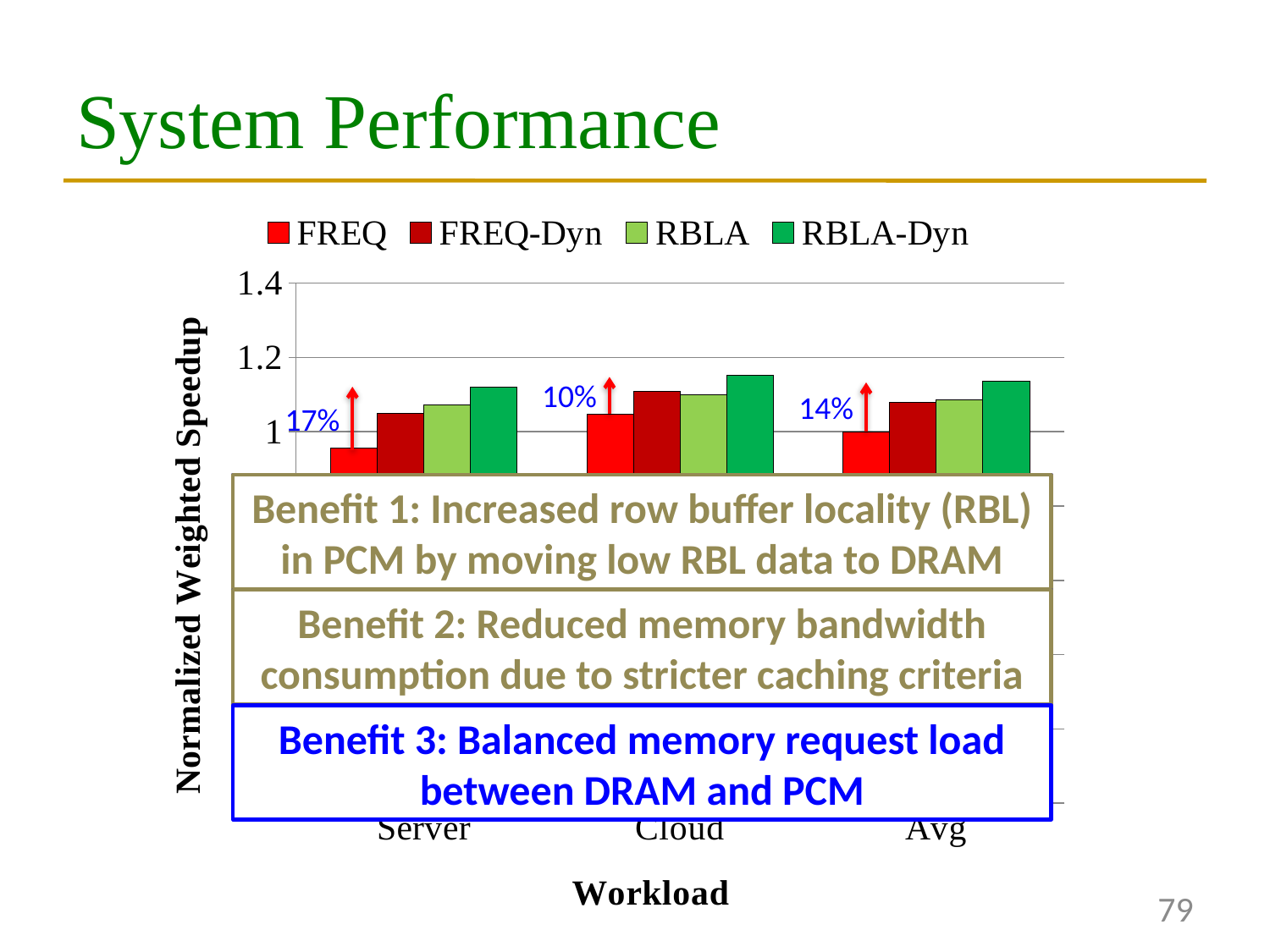
What is the title of the y axis? Normalized Weighted Speedup Is the FREQ value for Server greater or less than 1? less Which series has the highest bar for the Server workload? RBLA-Dyn What percentage improvement is annotated above the Server workload? 17% What kind of chart is shown on the slide? bar chart Is the RBLA-Dyn value for Cloud greater or less than 1.2? less Which is larger, the FREQ value for Server or the FREQ value for Cloud? Cloud How many workload categories are shown on the x axis? 3 How many series does the legend list? 4 Is the FREQ value for Cloud greater or less than 1? greater Which series has the highest bar for the Avg workload? RBLA-Dyn Which series has the lowest bar for the Cloud workload? FREQ